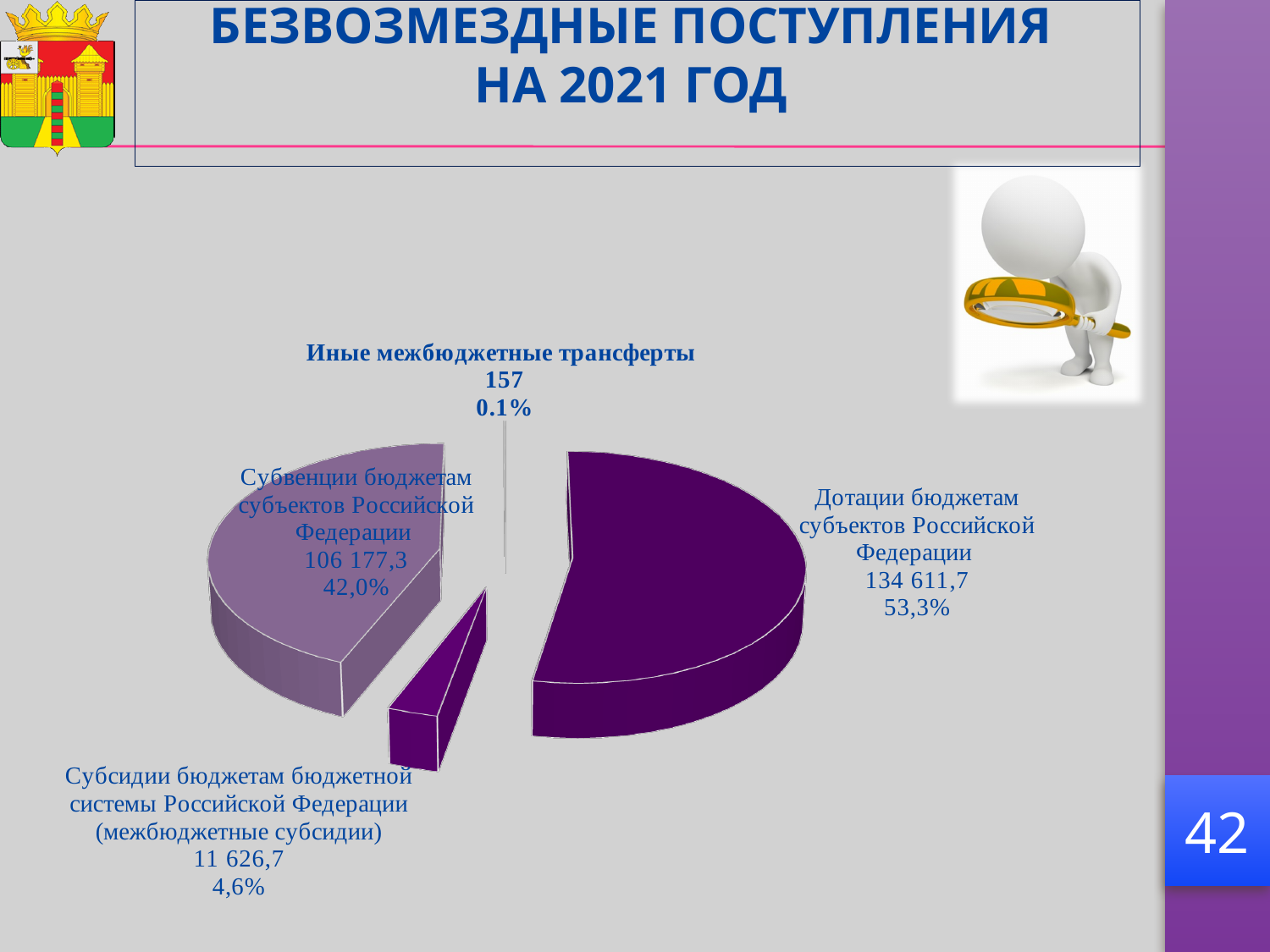
How many slices does the pie chart have? 4 What is the difference between the values for Дотации бюджетам субъектов Российской Федерации and Субвенции бюджетам субъектов Российской Федерации? 28 434,4 What share of the pie does Субвенции бюджетам субъектов Российской Федерации represent? 42,0% Which is larger: the value for Субсидии бюджетам бюджетной системы Российской Федерации (межбюджетные субсидии) or the value for Иные межбюджетные трансферты? Субсидии бюджетам бюджетной системы Российской Федерации (межбюджетные субсидии) What is the value for Иные межбюджетные трансферты? 157 Which category has the largest share of the pie? Дотации бюджетам субъектов Российской Федерации What share of the pie does Субсидии бюджетам бюджетной системы Российской Федерации (межбюджетные субсидии) represent? 4,6% What is the value for Субвенции бюджетам субъектов Российской Федерации? 106 177,3 What is the value for Дотации бюджетам субъектов Российской Федерации? 134 611,7 What kind of chart is shown on the slide? pie chart What is the value for Субсидии бюджетам бюджетной системы Российской Федерации (межбюджетные субсидии)? 11 626,7 Which category has the smallest share of the pie? Иные межбюджетные трансферты